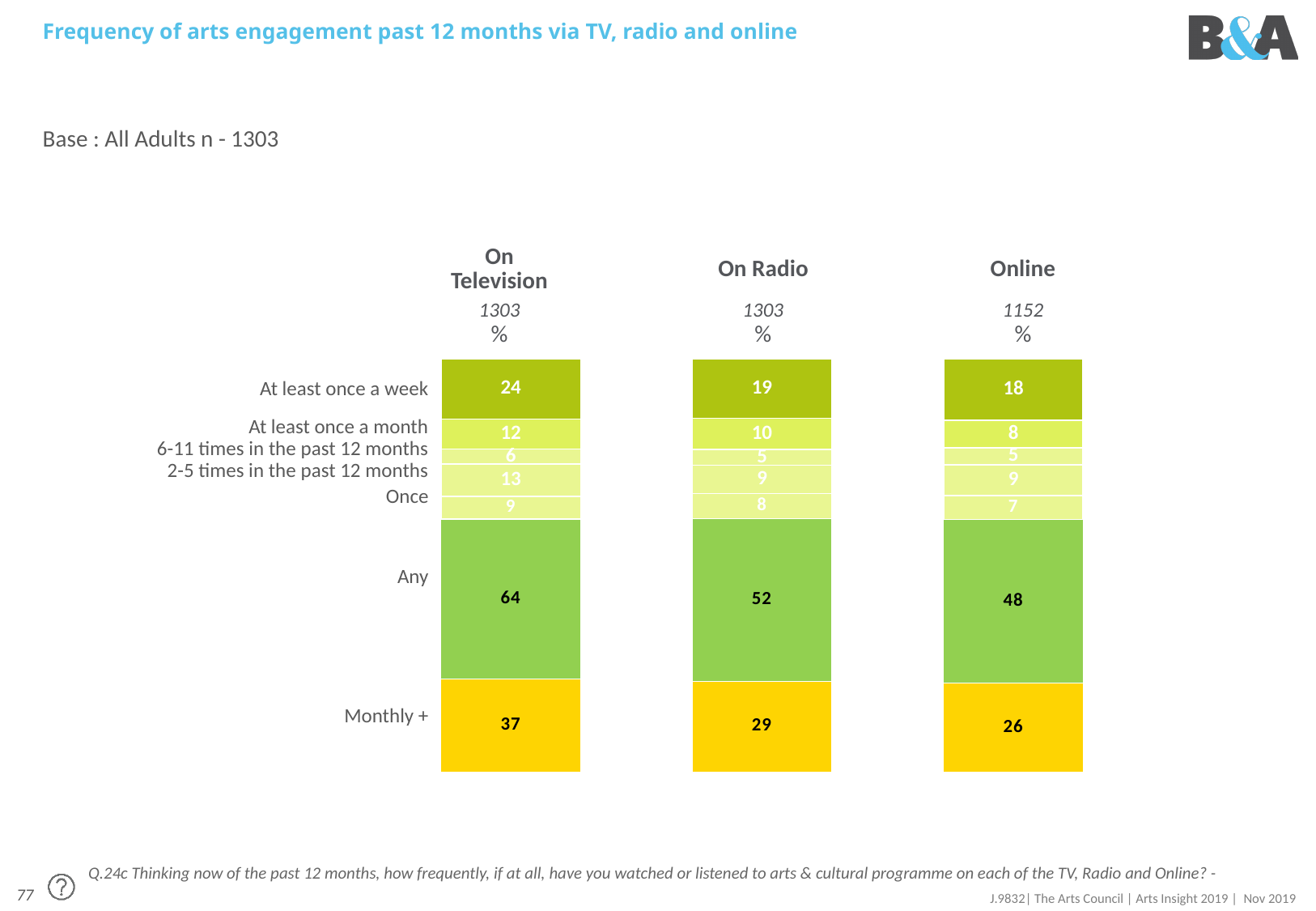
What is the base size shown for the Online bar? 1152 What percentage of adults engaged with arts on television at least once a week? 24 How many media (bars) are shown in the chart? 3 What is the 'Monthly +' value for Online? 26 What is the 'Any' value for On Radio? 52 What is the difference between the 'Monthly +' values for On Television and On Radio? 8 Which is larger, the 'At least once a month' value for On Radio or for Online? On Radio What is the value for '2-5 times in the past 12 months' for On Television? 13 What kind of chart is shown on the slide? Stacked bar chart What is the 'Once' value for On Radio? 8 Which medium has the highest 'Any' engagement value? On Television Which medium has the lowest 'At least once a week' value? Online